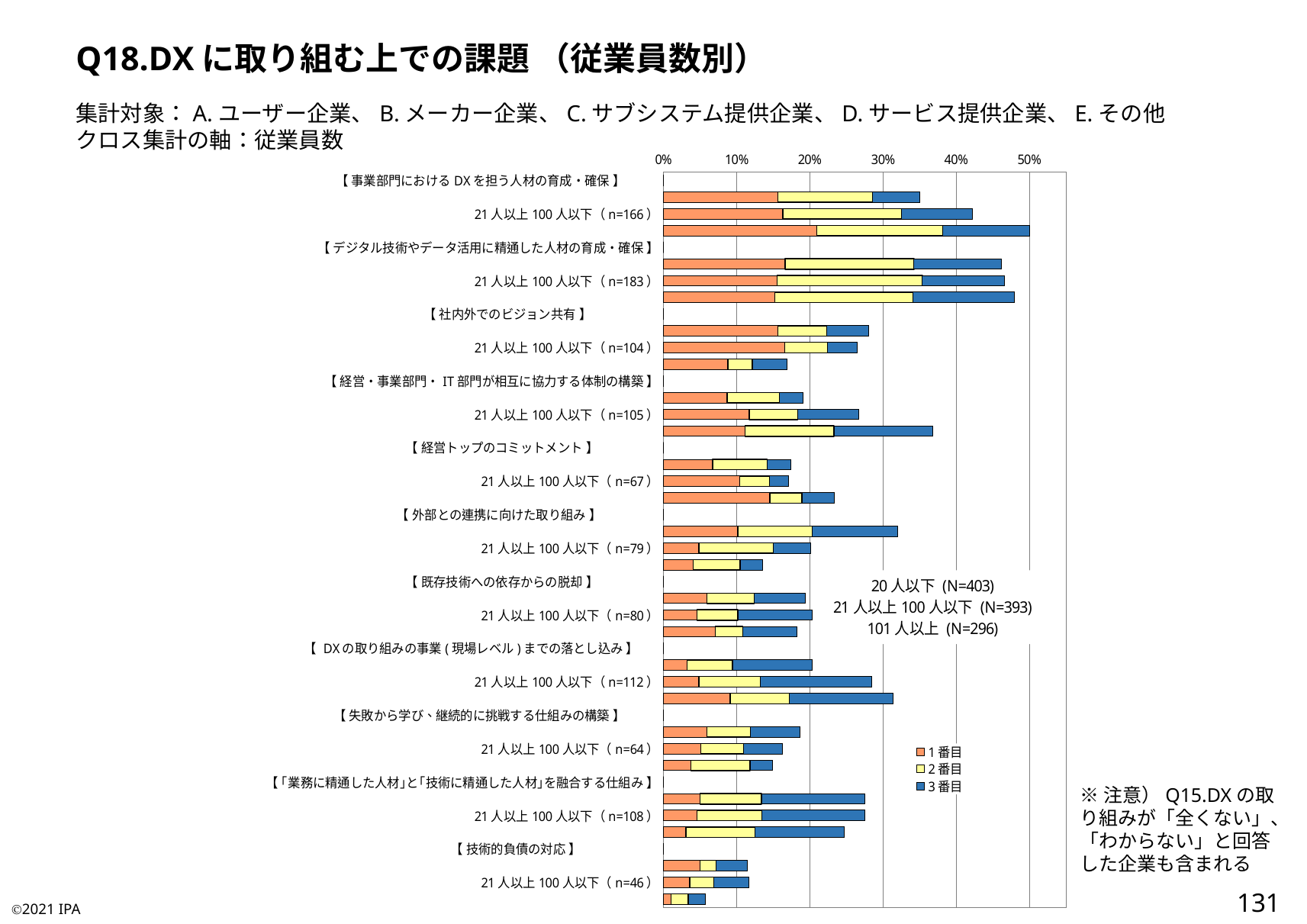
What is the highest percentage tick shown on the horizontal axis? 50% How many bars are plotted under each bracketed challenge category? 3 Is the total stacked value of the third (bottom) bar under 【技術的負債の対応】 greater or less than 10%? less Which challenge category has the shortest stacked bars overall? 技術的負債の対応 Which is larger: the total of the first bar under 【外部との連携に向けた取り組み】 or the total of the second bar (21人以上100人以下 n=79) in the same group? The first bar Is the total stacked value of the first (top) bar under 【事業部門におけるDXを担う人材の育成・確保】 greater or less than 30%? greater What kind of chart is shown on the slide? Stacked horizontal bar chart Which challenge category has the longest stacked bar overall? 事業部門におけるDXを担う人材の育成・確保 How many bracketed challenge categories (【 】 headings) are shown on the chart? 11 How many series does the legend list? 3 Is the total stacked value of the third (bottom) bar under 【社内外でのビジョン共有】 greater or less than 20%? less What are the three legend entries? 1番目, 2番目, 3番目